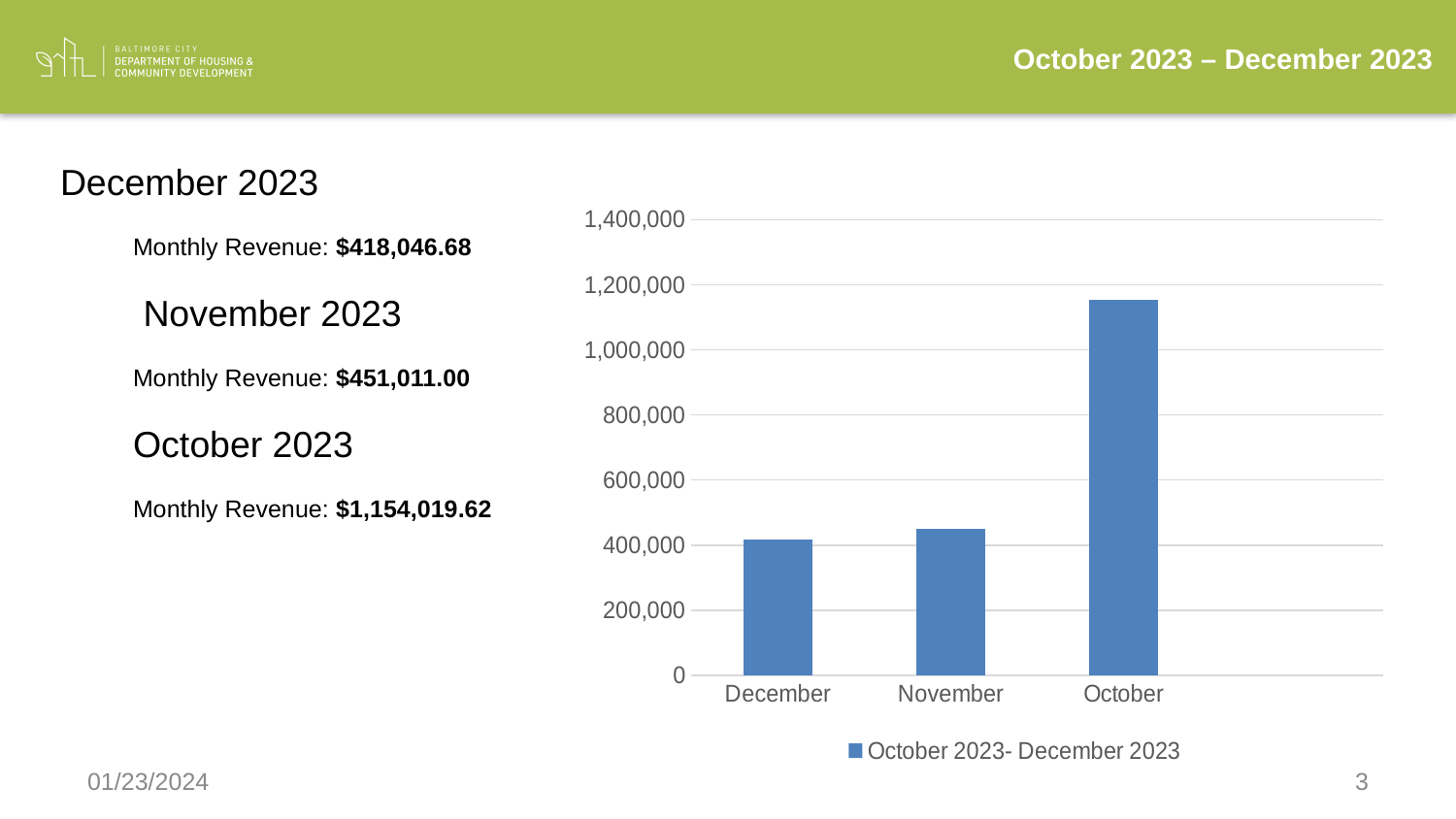
How many months are plotted in the chart? 3 Is the value for October greater or less than 1,000,000? greater Which month has the lowest bar in the chart? December Using the revenue figures printed on the slide, how much higher is October's revenue than November's? $703,008.62 What kind of chart is shown on the slide? bar chart Is the value for December greater or less than 400,000? greater Which month has the highest bar in the chart? October How many series does the chart legend list? 1 What is the monthly revenue for December 2023 as stated on the slide? $418,046.68 Is the value for November greater or less than 600,000? less What is the monthly revenue for October 2023 as stated on the slide? $1,154,019.62 What is the legend entry for the chart? October 2023- December 2023